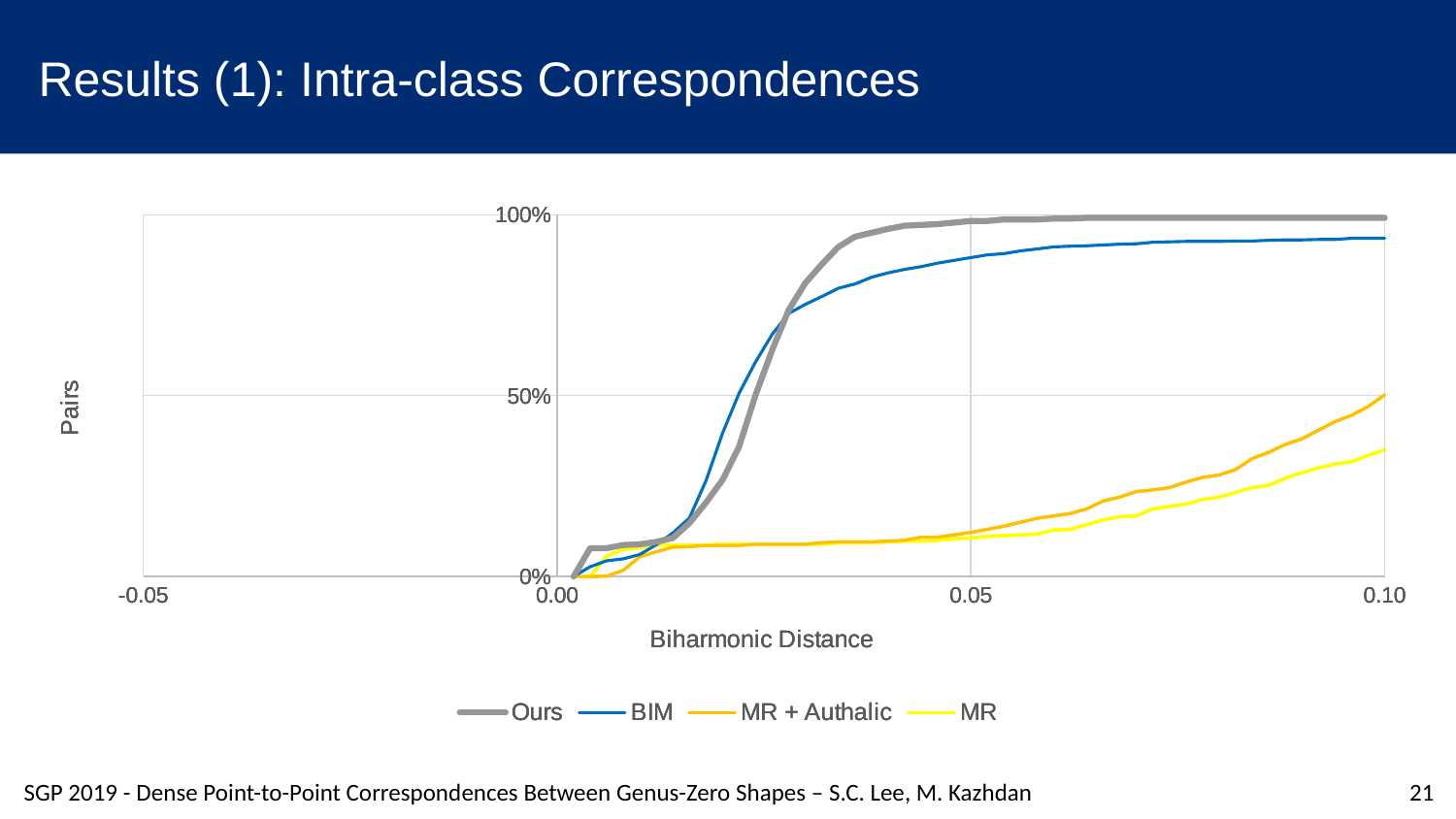
Do the values for MR rise or fall as biharmonic distance increases? rise Which series has the lowest value at a biharmonic distance of 0.10? MR Is the value for MR + Authalic at a biharmonic distance of 0.05 greater or less than 50%? less How many series does the legend list? 4 At a biharmonic distance of 0.10, which series has the higher value, BIM or MR + Authalic? BIM What kind of chart is shown on the slide? line chart Is the value for Ours at a biharmonic distance of 0.05 greater or less than 50%? greater At a biharmonic distance of 0.05, which series has the higher value, Ours or BIM? Ours Is the value for MR at a biharmonic distance of 0.10 greater or less than 50%? less Which series has the highest value at a biharmonic distance of 0.10? Ours What are the series names listed in the legend? Ours, BIM, MR + Authalic, MR What is the title of the x axis? Biharmonic Distance